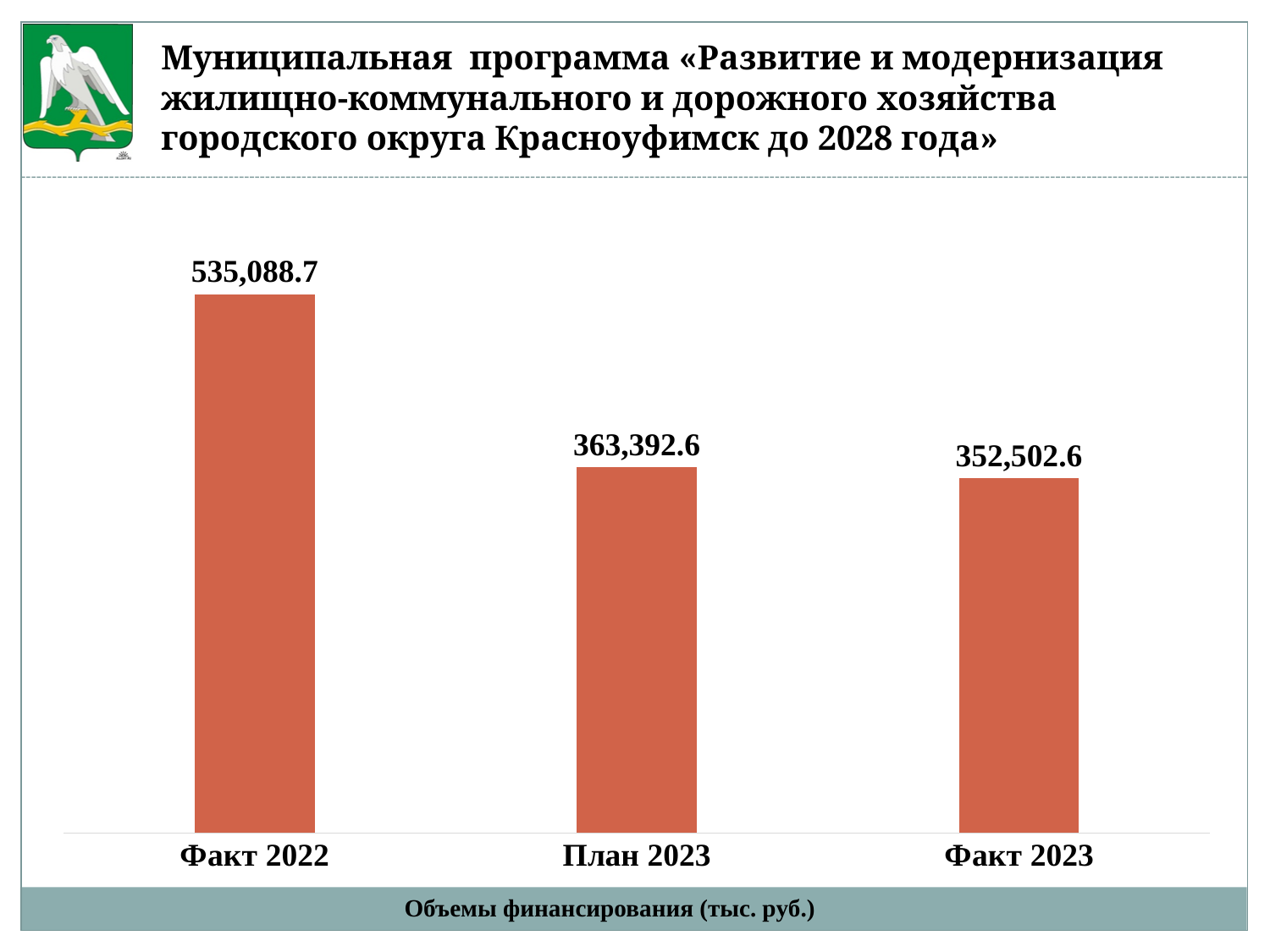
What is the value for План 2023? 363,392.6 What is the value for Факт 2022? 535,088.7 What is the difference between the values for Факт 2022 and План 2023? 171,696.1 Which category has the highest value? Факт 2022 What is the difference between the values for План 2023 and Факт 2023? 10,890.0 What is the difference between the values for Факт 2022 and Факт 2023? 182,586.1 Which is larger, the value for План 2023 or the value for Факт 2023? План 2023 How many bars are shown in the chart? 3 What kind of chart is shown on the slide? Bar chart Which category has the lowest value? Факт 2023 Do the values rise or fall from left to right along the x axis? Fall What is the value for Факт 2023? 352,502.6